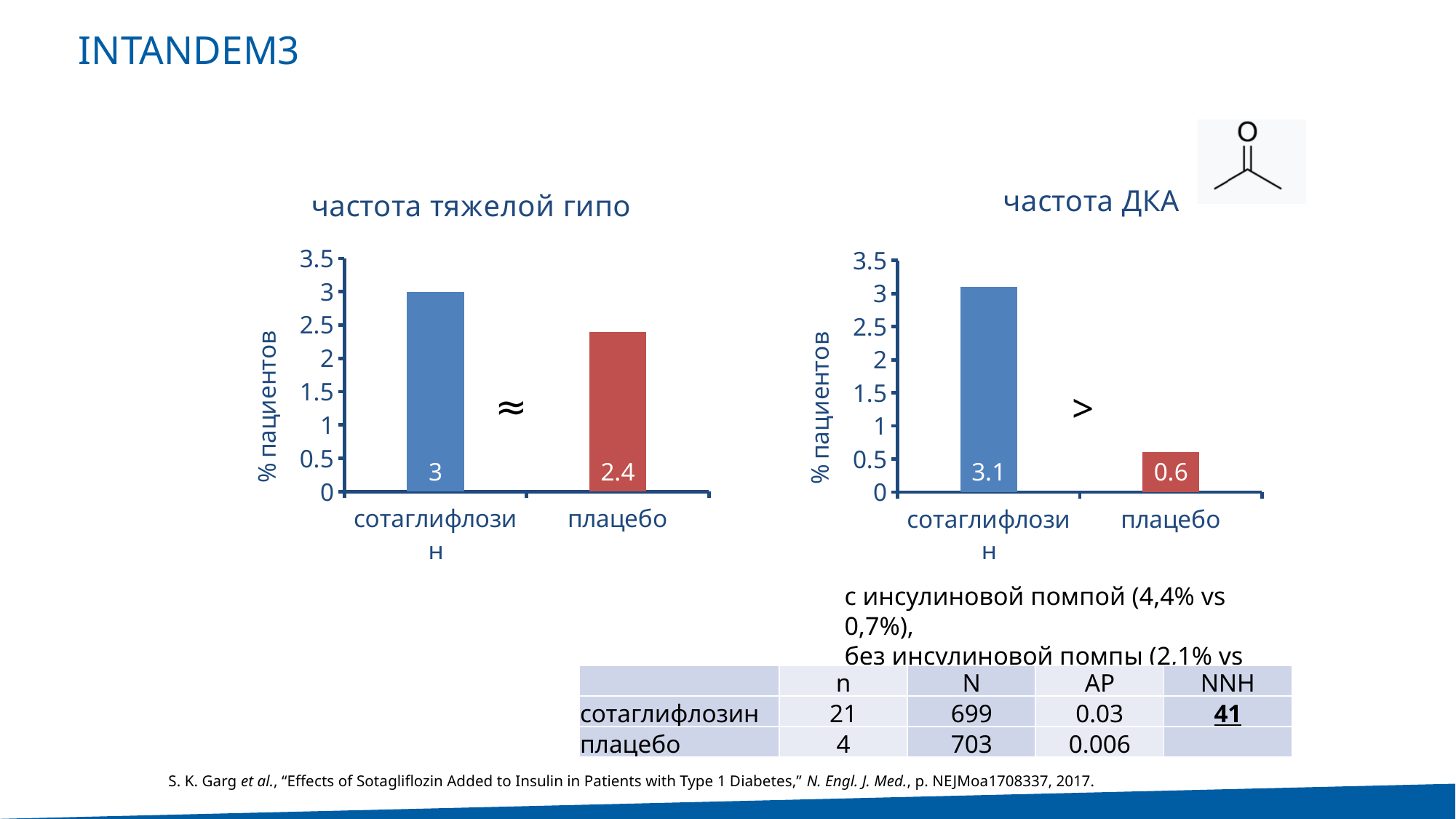
In the chart titled "частота тяжелой гипо", which category has the highest value? сотаглифлозин How many categories are shown in the chart titled "частота тяжелой гипо"? 2 In the chart titled "частота ДКА", what is the value for плацебо? 0.6 In the chart titled "частота тяжелой гипо", what is the value for плацебо? 2.4 In the chart titled "частота тяжелой гипо", what is the value for сотаглифлозин? 3 In the chart titled "частота ДКА", which is larger, the value for сотаглифлозин or for плацебо? сотаглифлозин In the chart titled "частота тяжелой гипо", what is the difference between the values for сотаглифлозин and плацебо? 0.6 In the chart titled "частота ДКА", what is the value for сотаглифлозин? 3.1 What is the y-axis label of the chart titled "частота тяжелой гипо"? % пациентов What kind of chart is the chart titled "частота ДКА"? bar chart In the chart titled "частота ДКА", what is the difference between the values for сотаглифлозин and плацебо? 2.5 In the chart titled "частота ДКА", which category has the lowest value? плацебо